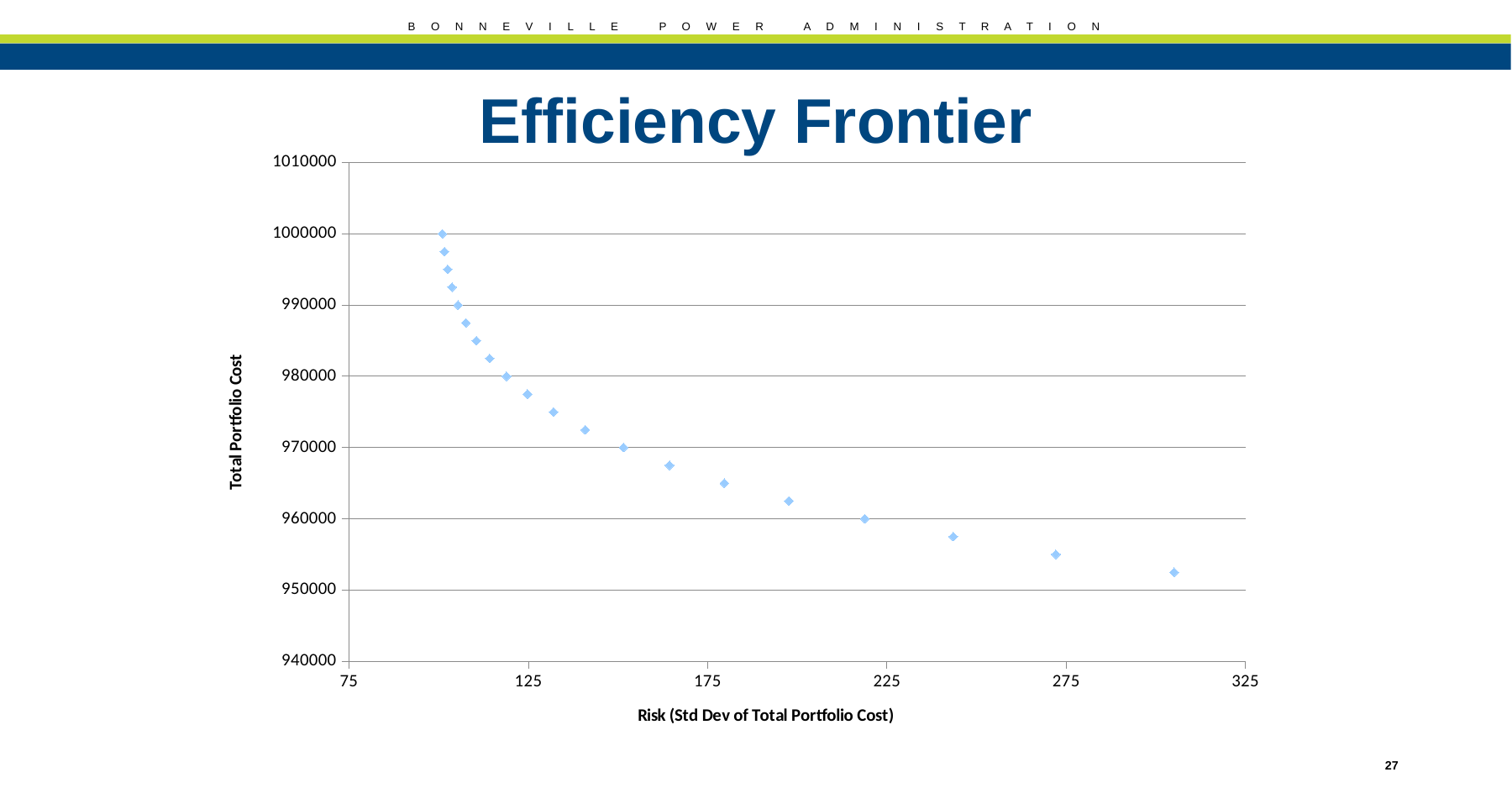
Is the total portfolio cost of the point at a risk of about 225 greater or less than 970000? less What is the title of the chart? Efficiency Frontier What is the label of the vertical axis? Total Portfolio Cost How many data points are plotted on the chart? 20 As risk increases along the x axis, does total portfolio cost rise or fall? Fall Is the risk value of the rightmost point greater or less than 275? greater Is the total portfolio cost of the point with the highest risk greater or less than 960000? less Which has the higher total portfolio cost: the point with the lowest risk or the point with the highest risk? The point with the lowest risk What kind of chart is shown on the slide? Scatter chart Does the point with the highest total portfolio cost have the lowest or the highest risk? The lowest risk